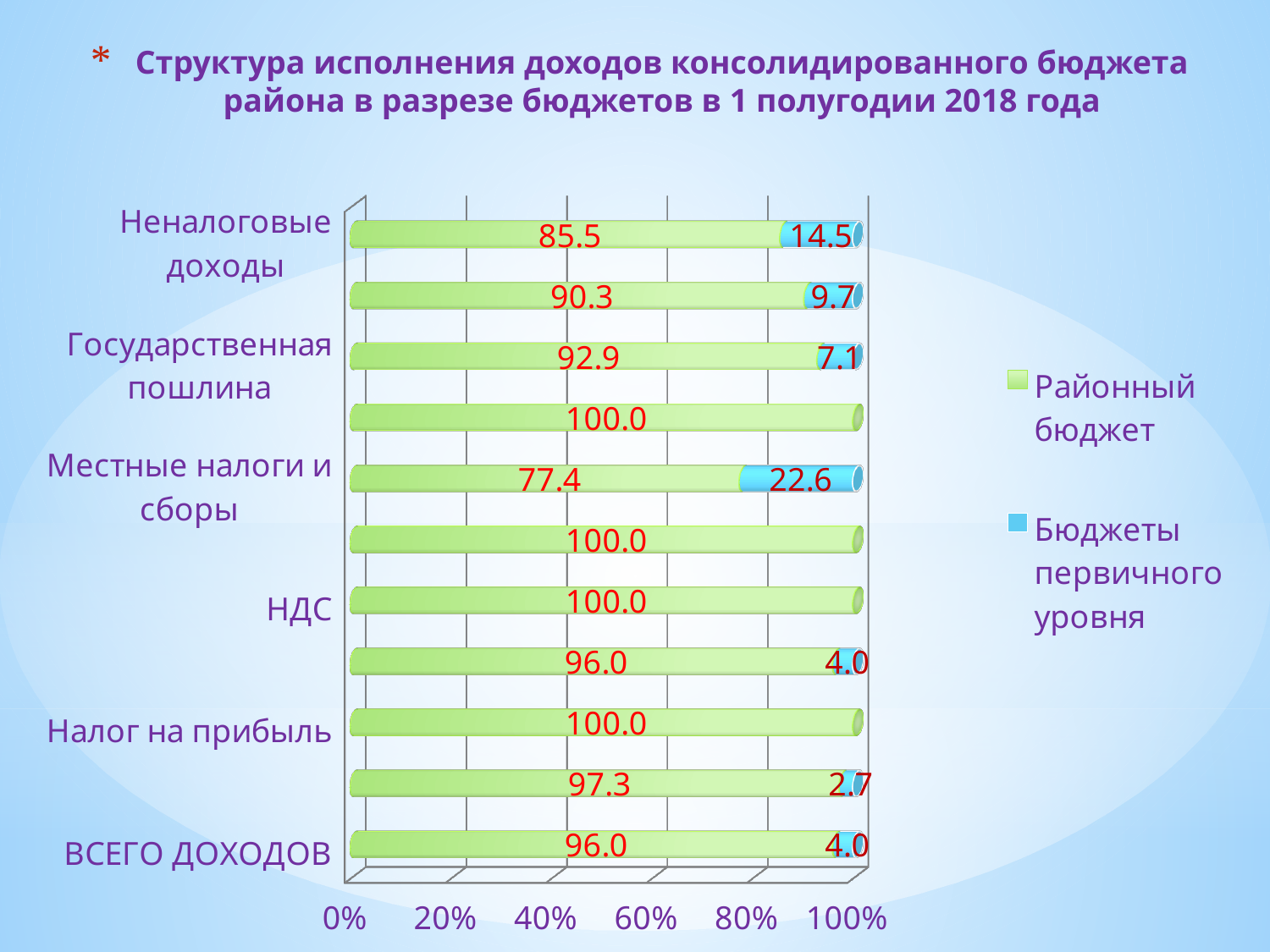
Which has the larger Районный бюджет value: Неналоговые доходы or Государственная пошлина? Государственная пошлина Which category has the lowest value for Районный бюджет? Местные налоги и сборы What is the value of Бюджеты первичного уровня for Местные налоги и сборы? 22.6 Which category has the highest value for Бюджеты первичного уровня? Местные налоги и сборы What is the value of Районный бюджет for НДС? 100.0 What kind of chart is shown on the slide? Stacked horizontal bar chart What is the total of the stacked bar for Неналоговые доходы? 100.0 What is the value of Бюджеты первичного уровня for ВСЕГО ДОХОДОВ? 4.0 What is the value of Районный бюджет for Государственная пошлина? 92.9 What is the value of Районный бюджет for Неналоговые доходы? 85.5 How many series does the legend list? 2 What is the difference between the Районный бюджет and Бюджеты первичного уровня values for Неналоговые доходы? 71.0